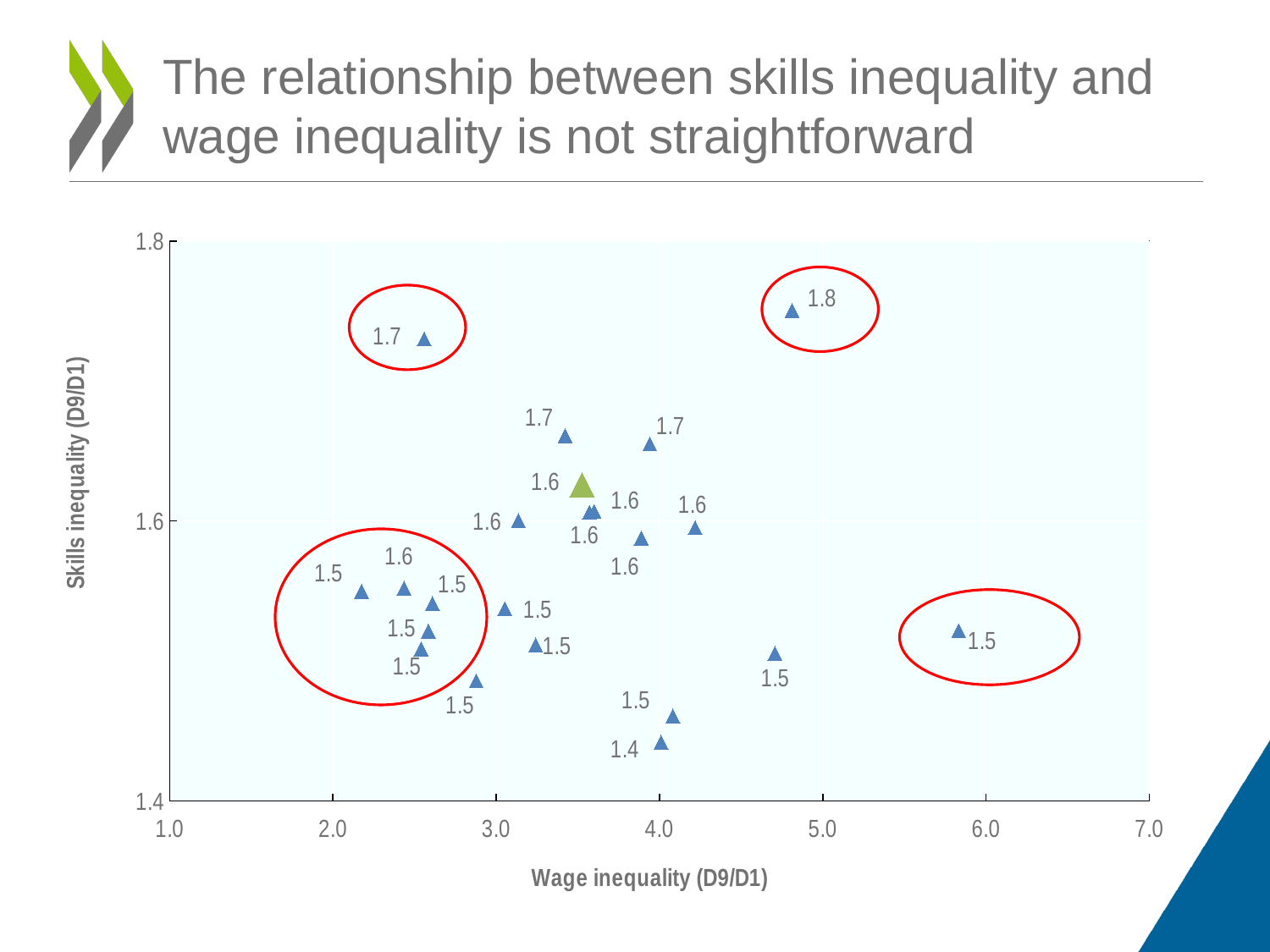
What is the title of the horizontal axis of the chart? Wage inequality (D9/D1) What is the highest skills inequality value labelled on any point in the chart? 1.8 What skills inequality value is labelled on the green triangle in the chart? 1.6 What is the title of the vertical axis of the chart? Skills inequality (D9/D1) What is the lowest skills inequality value labelled on any point in the chart? 1.4 What skills inequality value is labelled on the point with the highest wage inequality (the one circled on the far right)? 1.5 What is the difference between the highest labelled skills inequality value (1.8) and the lowest labelled value (1.4)? 0.4 Is the wage inequality of the circled point on the far right greater or less than 5.0? greater Which has the higher wage inequality: the circled point labelled 1.8 or the circled point labelled 1.7 in the upper left? The point labelled 1.8 Is the wage inequality of the circled point labelled 1.7 in the upper left greater or less than 3.0? less Is the wage inequality of the point labelled 1.8 greater or less than 4.0? greater What kind of chart is shown on the slide? Scatter chart